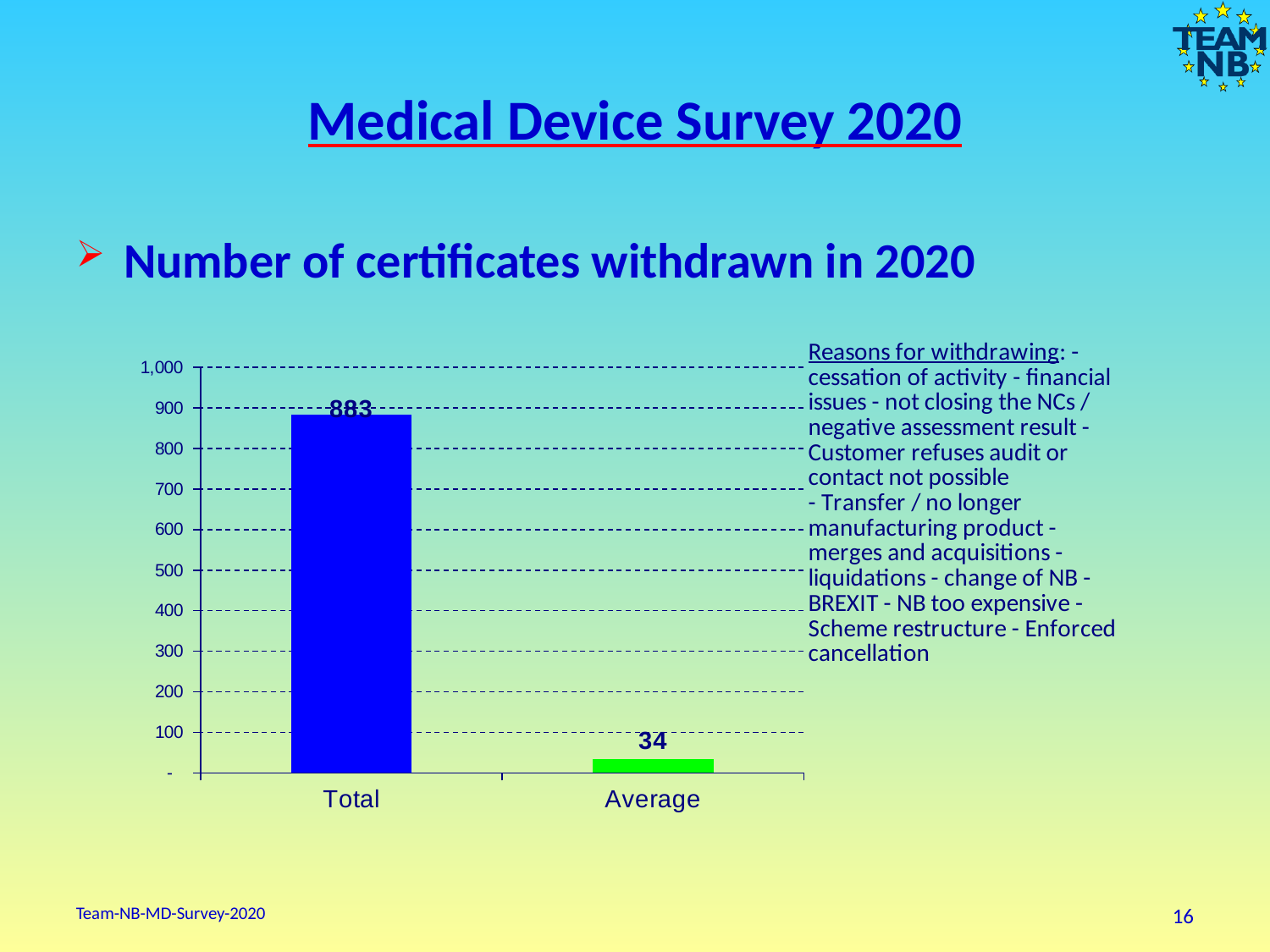
How many categories are shown on the x axis? 2 What is the value of the Average bar? 34 What is the value of the Total bar? 883 What is the difference between the Total and Average values? 849 Which is larger, the Total value or the Average value? Total Is the value for Average greater or less than 100? less Which category has the highest value? Total What colour is the Total bar? blue What is the highest value shown on the y axis? 1,000 What kind of chart is shown on the slide? bar chart Which category has the lowest value? Average Is the value for Total greater or less than 800? greater